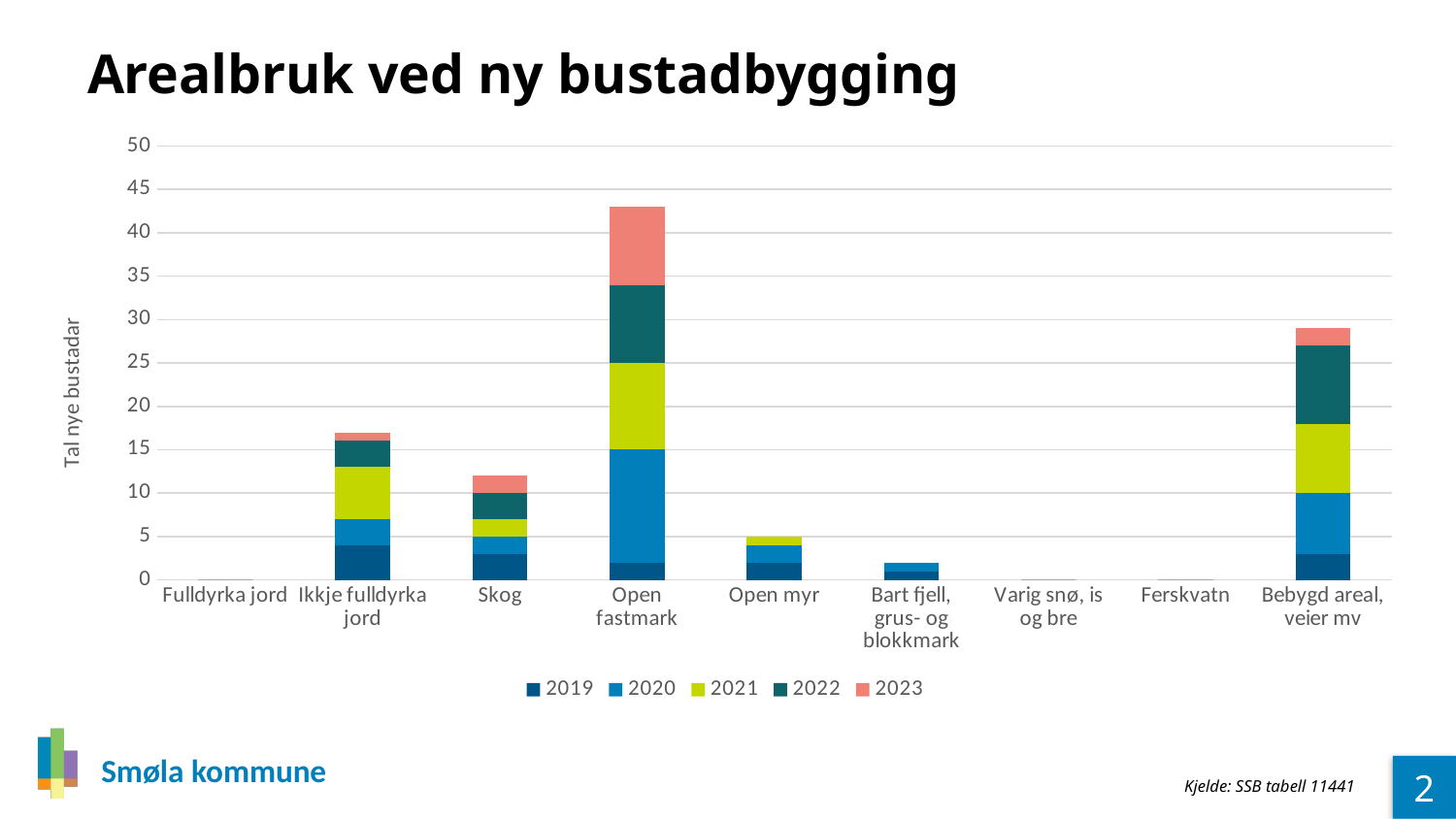
What is the title of the chart? Arealbruk ved ny bustadbygging What kind of chart is shown on the slide? stacked bar chart Which has a larger total, Bebygd areal, veier mv or Ikkje fulldyrka jord? Bebygd areal, veier mv Is the total value for Bebygd areal, veier mv greater or less than 25? greater Is the total value for Open fastmark greater or less than 40? greater How many categories are shown on the x axis? 9 What is the label of the y axis? Tal nye bustadar Which category has the highest total stacked bar? Open fastmark Is the total value for Open myr greater or less than 10? less How many series does the legend list? 5 Which has a larger total, Skog or Open myr? Skog